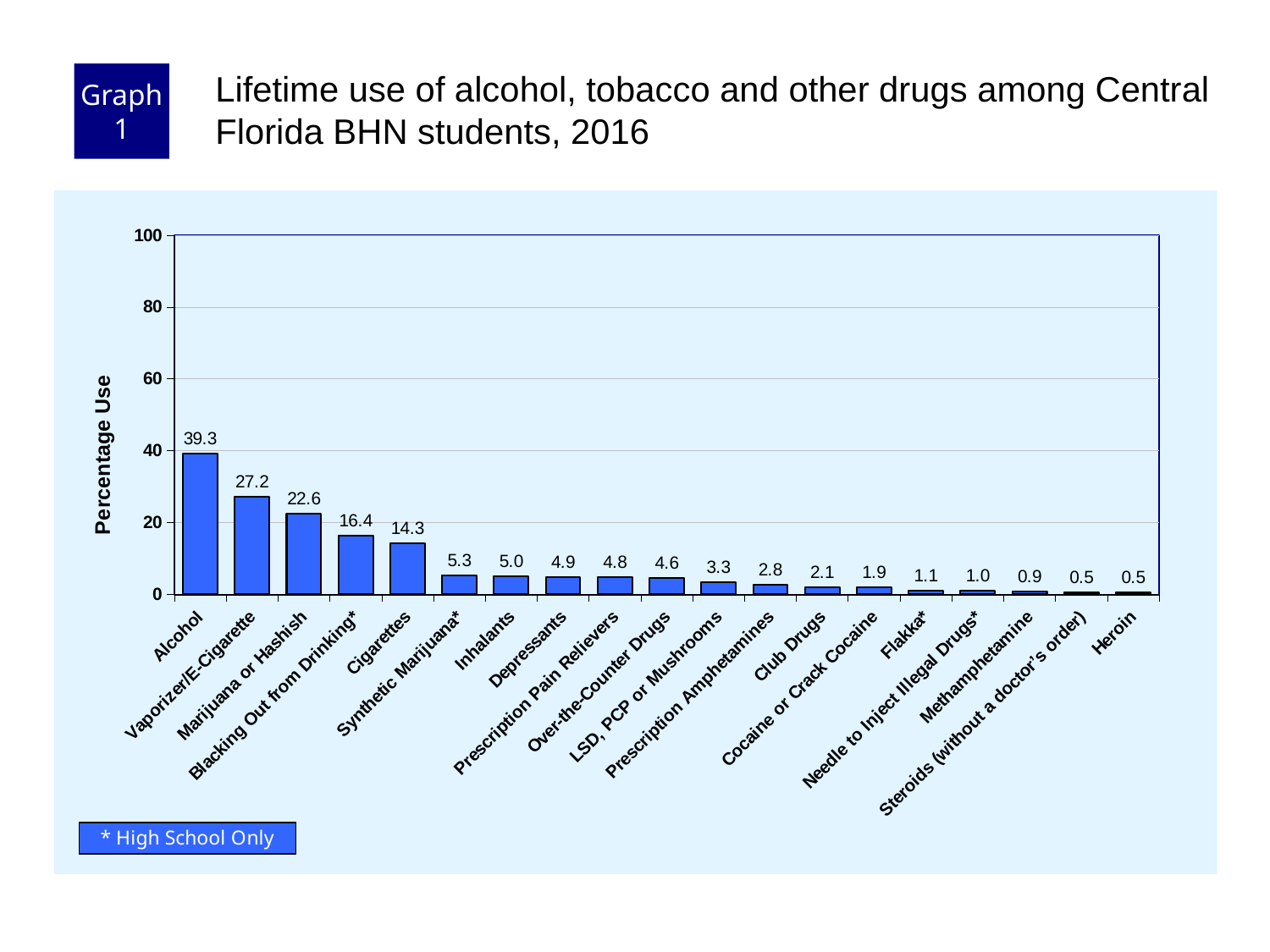
Do the values rise or fall from left to right along the x axis? fall What kind of chart is shown on the slide? bar chart What is the percentage use for Club Drugs? 2.1 What is the label of the y axis? Percentage Use What does the asterisk (*) after some category names indicate, according to the note on the slide? High School Only Is the value for Blacking Out from Drinking* greater or less than 20? less Which has a higher percentage use, Marijuana or Hashish or Cigarettes? Marijuana or Hashish How many categories are shown on the x axis? 19 What is the percentage use for Alcohol? 39.3 Which category has the highest percentage use? Alcohol What is the percentage use for Cigarettes? 14.3 What is the difference in percentage use between Alcohol and Vaporizer/E-Cigarette? 12.1